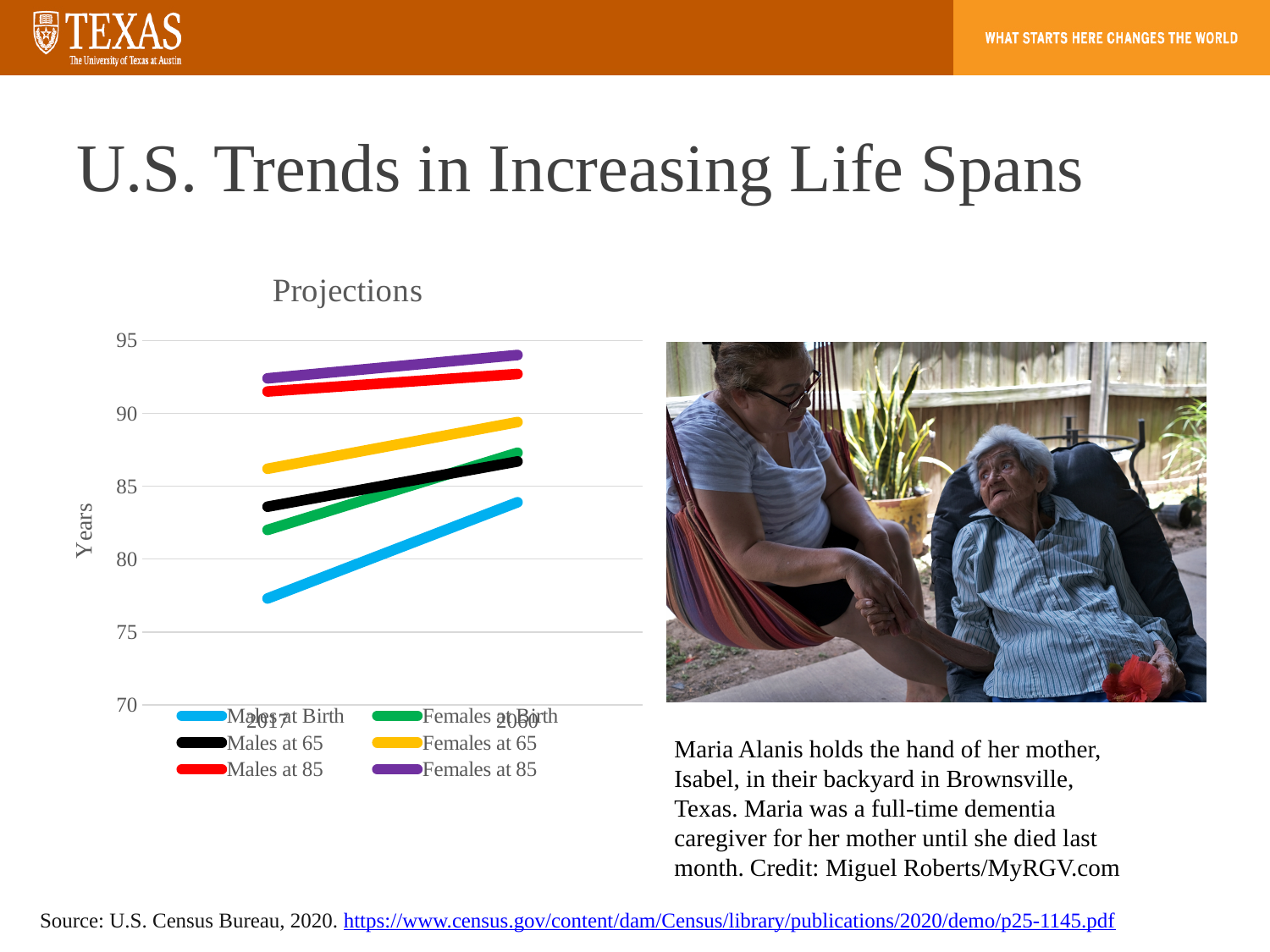
What is the label on the y axis of the Projections chart? Years In the Projections chart, which series has the lowest value in 2017? Males at Birth In the Projections chart, does the value for Males at Birth rise or fall from 2017 to 2060? rise What is the title of the chart on the slide? Projections In the Projections chart, is the value for Females at Birth in 2017 greater or less than 80? greater How many years are plotted on the x axis of the Projections chart? 2 In the Projections chart, is the value for Females at 85 in 2060 greater or less than 90? greater What kind of chart is shown under the title "Projections"? line chart In the Projections chart, which is larger in 2060: Females at 65 or Males at 65? Females at 65 How many series does the legend of the Projections chart list? 6 In the Projections chart, which series has the highest value in 2060? Females at 85 In the Projections chart, is the value for Males at Birth in 2017 greater or less than 80? less